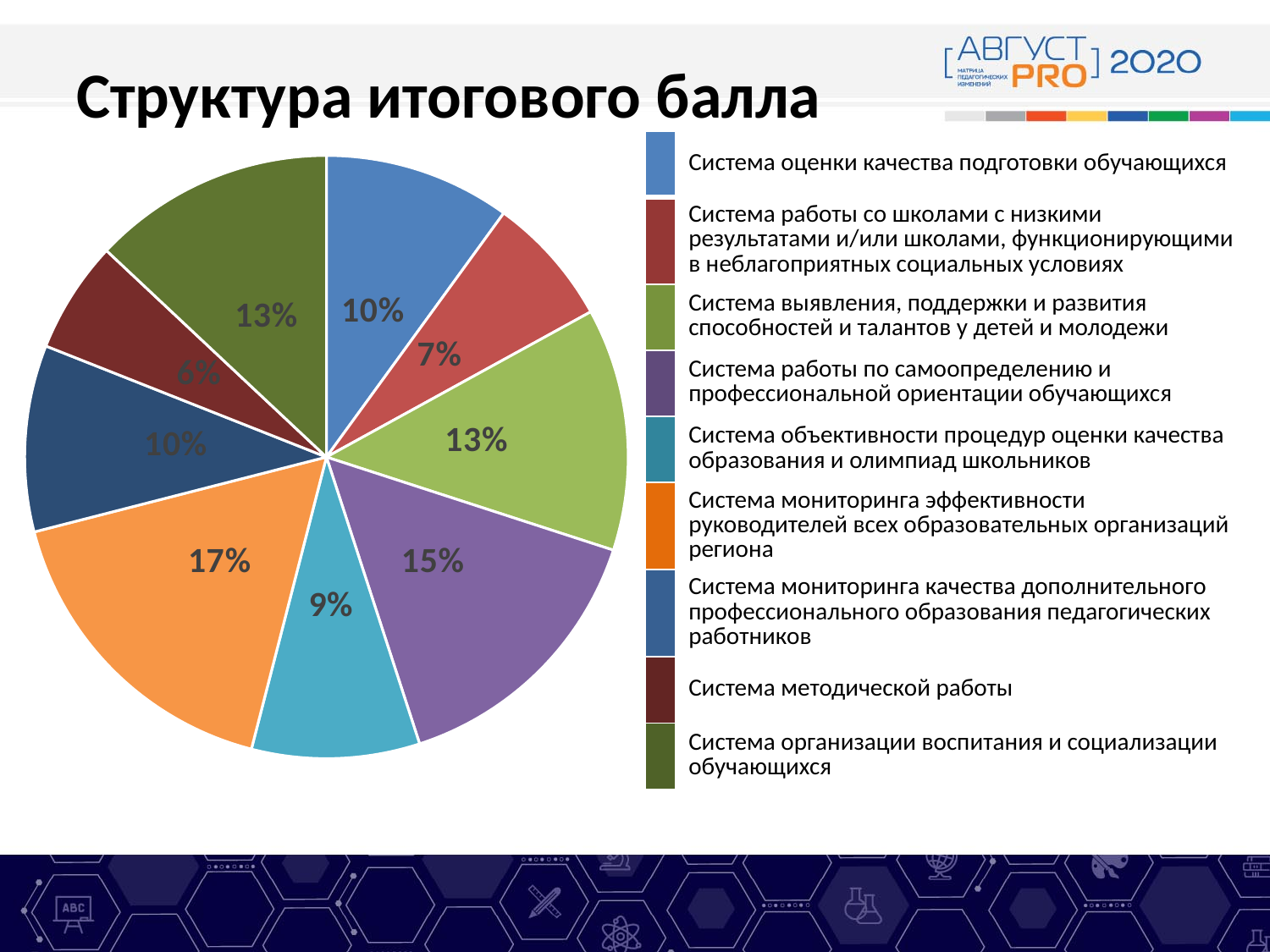
What kind of chart is shown on the slide? pie chart What share does "Система объективности процедур оценки качества образования и олимпиад школьников" have? 9% What share does "Система методической работы" have in the pie chart? 6% Which has a larger share: "Система работы по самоопределению и профессиональной ориентации обучающихся" or "Система оценки качества подготовки обучающихся"? Система работы по самоопределению и профессиональной ориентации обучающихся What is the difference between the share of "Система мониторинга эффективности руководителей всех образовательных организаций региона" and "Система методической работы"? 11% What is the title of the slide's chart? Структура итогового балла What share does "Система работы со школами с низкими результатами и/или школами, функционирующими в неблагоприятных социальных условиях" have? 7% What share does "Система работы по самоопределению и профессиональной ориентации обучающихся" have? 15% Which category has the largest share in the pie chart? Система мониторинга эффективности руководителей всех образовательных организаций региона What share does "Система мониторинга эффективности руководителей всех образовательных организаций региона" have? 17% Which category has the smallest share in the pie chart? Система методической работы How many slices does the pie chart have? 9